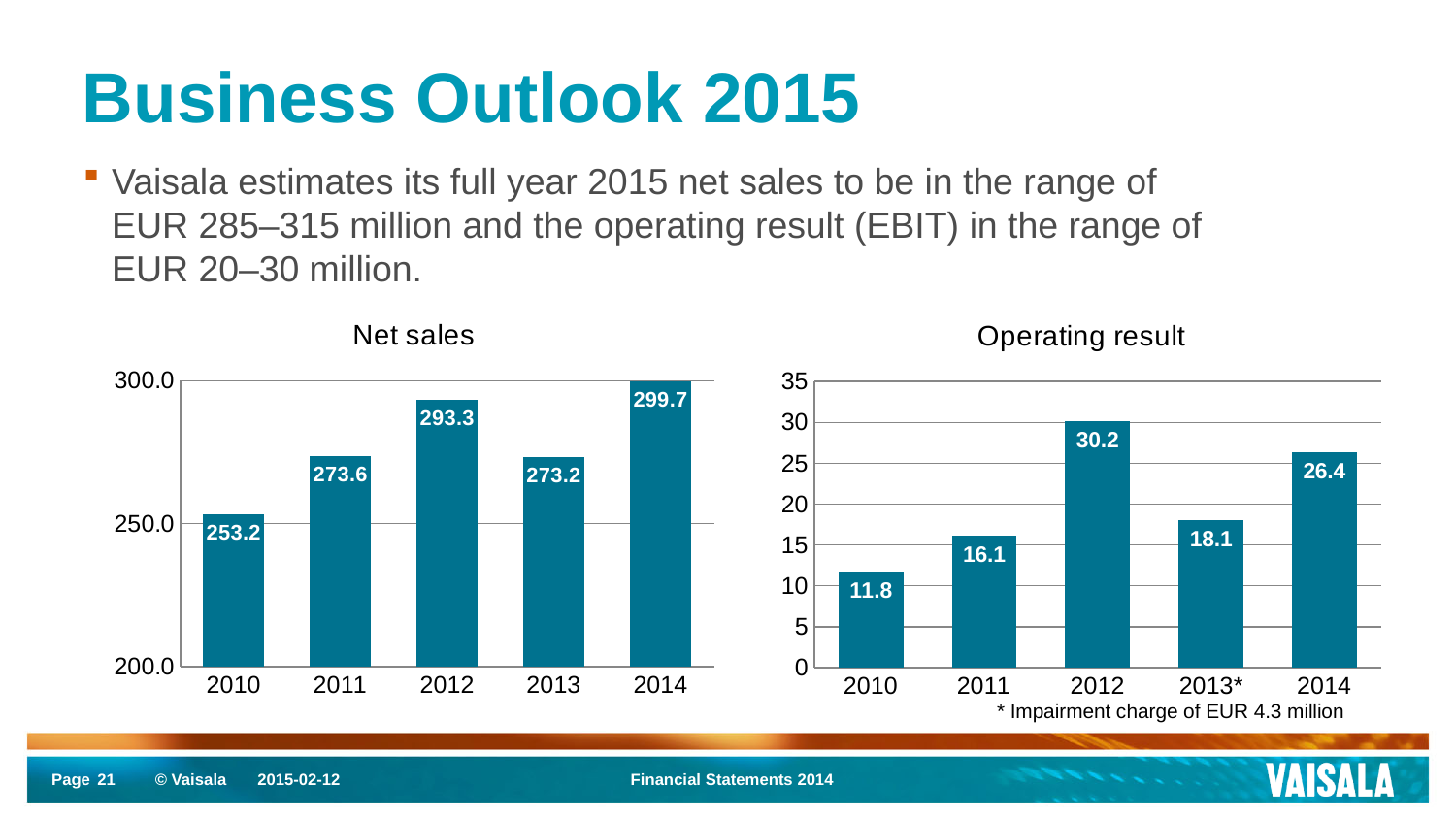
In the Operating result chart, what is the difference between the 2012 and 2013* values? 12.1 In the Net sales chart, which year has the highest value? 2014 In the Net sales chart, what is the difference between the 2014 and 2010 values? 46.5 What does the asterisk on 2013* in the Operating result chart refer to? Impairment charge of EUR 4.3 million In the Operating result chart, which year has the lowest value? 2010 What kind of chart is the Operating result chart? bar chart In the Net sales chart, what is the value for 2012? 293.3 How many years are shown in the Net sales chart? 5 In the Net sales chart, which is larger, the value for 2011 or the value for 2013? 2011 In the Operating result chart, what is the value for 2013*? 18.1 In the Operating result chart, what is the value for 2010? 11.8 In the Operating result chart, is the value for 2014 greater or less than 25? greater